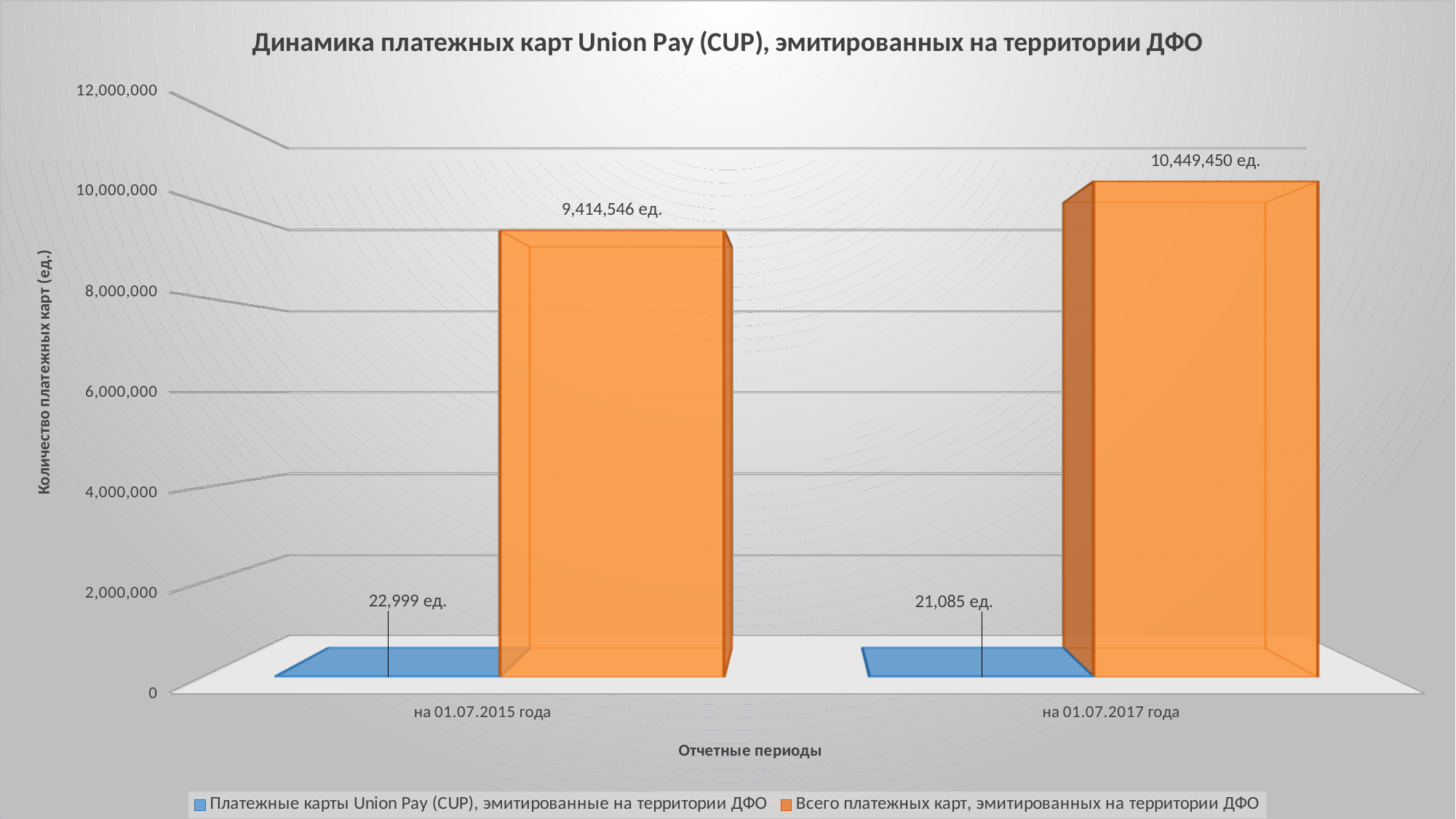
What is the value for 'Всего платежных карт, эмитированных на территории ДФО' on 01.07.2017? 10,449,450 ед. What is the value for 'Всего платежных карт, эмитированных на территории ДФО' on 01.07.2015? 9,414,546 ед. What is the difference between the number of Union Pay (CUP) cards on 01.07.2015 and on 01.07.2017? 1,914 ед. Which reporting period has the higher number of Union Pay (CUP) cards issued in the ДФО? на 01.07.2015 года What is the value for 'Платежные карты Union Pay (CUP), эмитированные на территории ДФО' on 01.07.2015? 22,999 ед. How many reporting periods are shown on the x axis? 2 By how much did the total number of payment cards issued in the ДФО increase from 01.07.2015 to 01.07.2017? 1,034,904 ед. Did the number of Union Pay (CUP) cards issued in the ДФО rise or fall from 01.07.2015 to 01.07.2017? fall What is the value for 'Платежные карты Union Pay (CUP), эмитированные на территории ДФО' on 01.07.2017? 21,085 ед. How many series does the legend list? 2 Did the total number of payment cards issued in the ДФО rise or fall from 01.07.2015 to 01.07.2017? rise What kind of chart is shown on the slide? bar chart